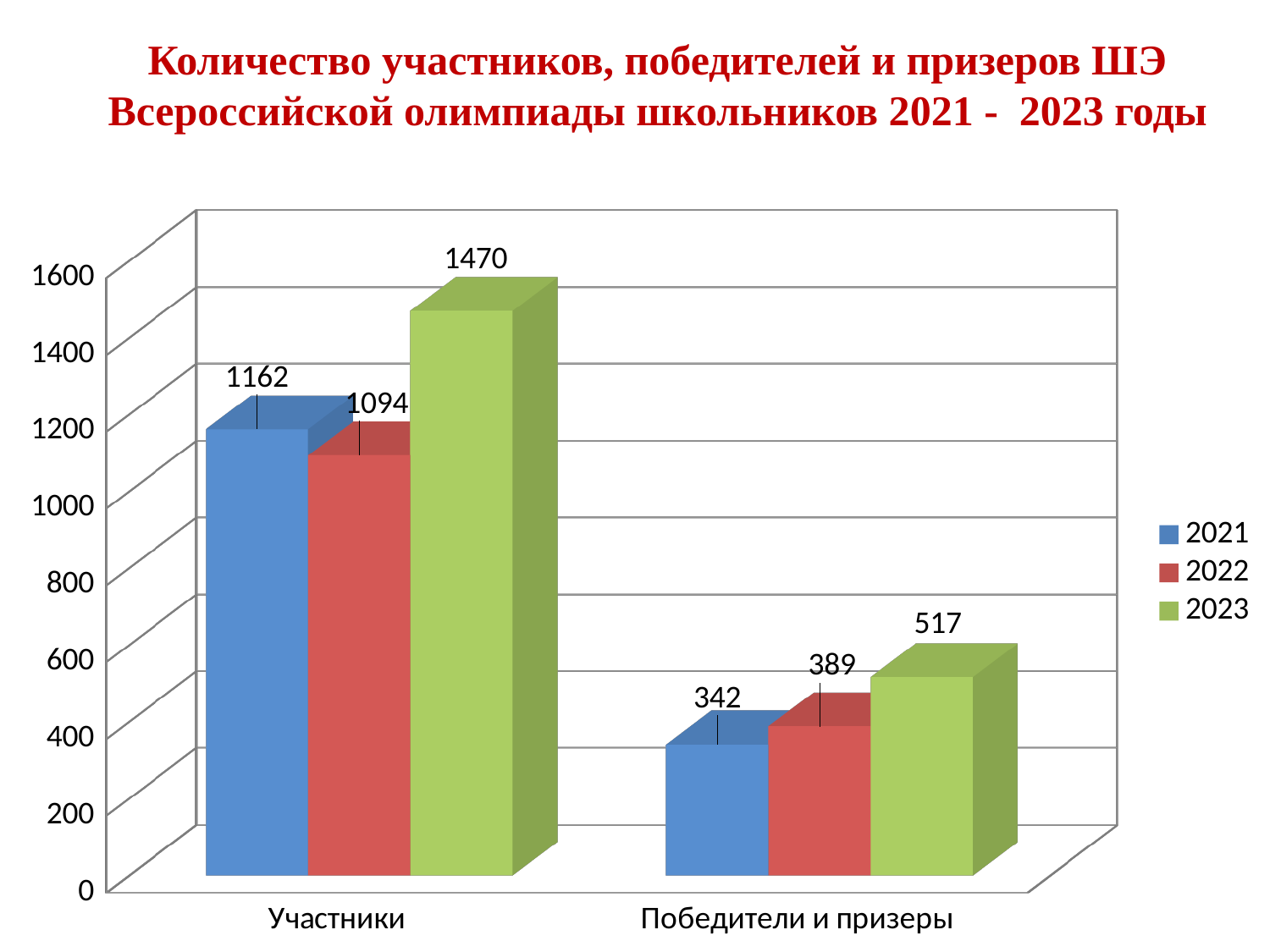
What is the value for 2021 in the Победители и призеры category? 342 How many series does the legend list? 3 What is the difference between the 2023 and 2021 values in the Участники category? 308 What is the value for 2022 in the Участники category? 1094 What is the value for 2023 in the Участники category? 1470 What is the difference between the 2022 and 2021 values in the Победители и призеры category? 47 How many categories are shown on the x axis? 2 Which is larger: the 2021 value or the 2022 value in the Участники category? 2021 Which year has the lowest value in the Участники category? 2022 Which year has the highest value in the Победители и призеры category? 2023 Which colour represents the 2023 series in the legend? green What kind of chart is shown on the slide? bar chart